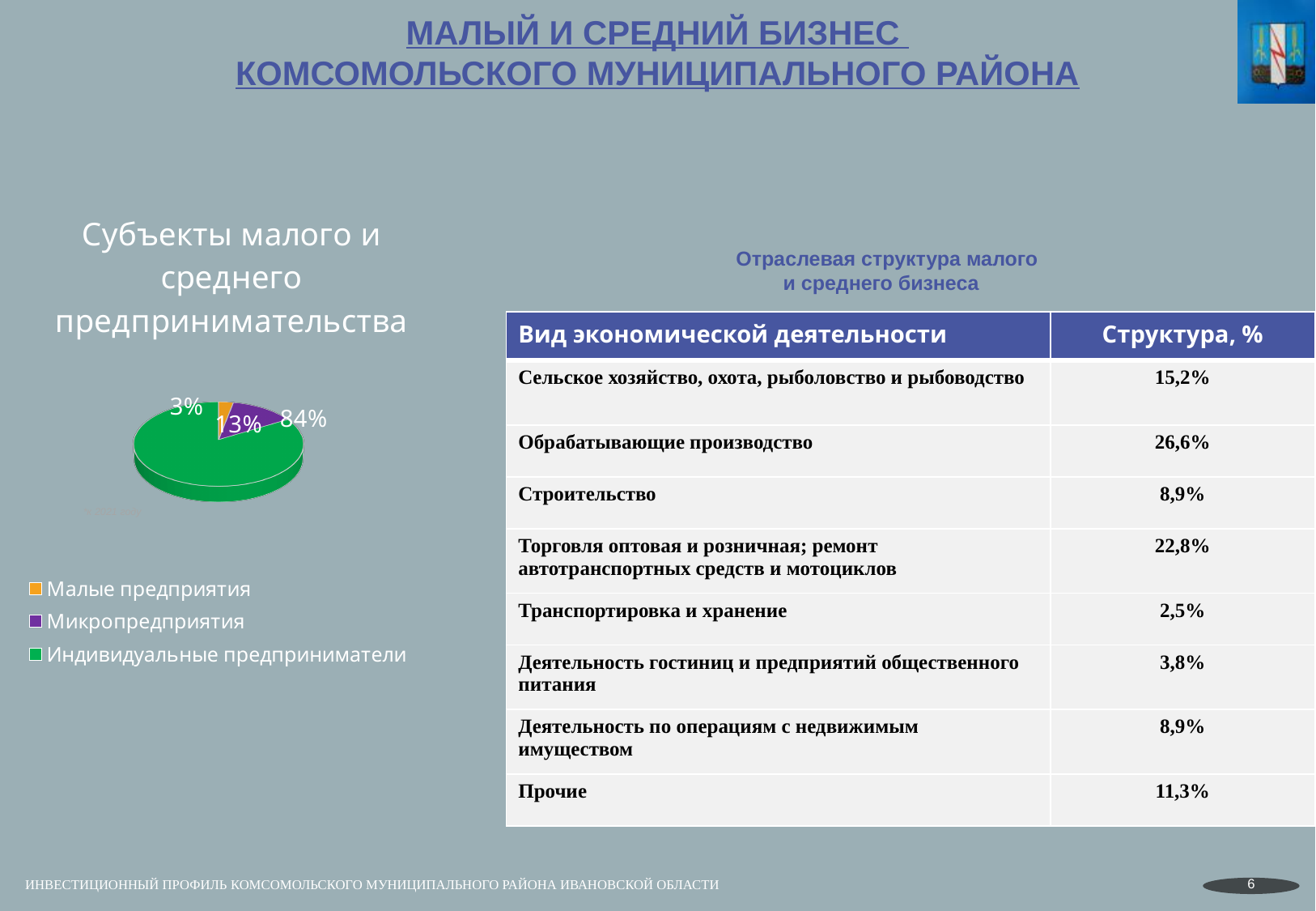
Which category has the largest slice in the pie chart? Индивидуальные предприниматели In the pie chart, by how many percentage points does the share of "Индивидуальные предприниматели" exceed the share of "Микропредприятия"? 71 percentage points In the pie chart, what share is shown for "Индивидуальные предприниматели"? 84% How many slices does the pie chart "Субъекты малого и среднего предпринимательства" have? 3 How many entries does the legend of the pie chart list? 3 Which category has the smallest slice in the pie chart? Малые предприятия What is the title of the pie chart on the slide? Субъекты малого и среднего предпринимательства In the pie chart, what share is shown for "Микропредприятия"? 13% In the pie chart, what share is shown for "Малые предприятия"? 3% In the pie chart, which is larger: the share of "Микропредприятия" or the share of "Малые предприятия"? Микропредприятия What kind of chart is shown on the left of the slide under the heading "Субъекты малого и среднего предпринимательства"? Pie chart What colour represents "Индивидуальные предприниматели" in the pie chart? Green